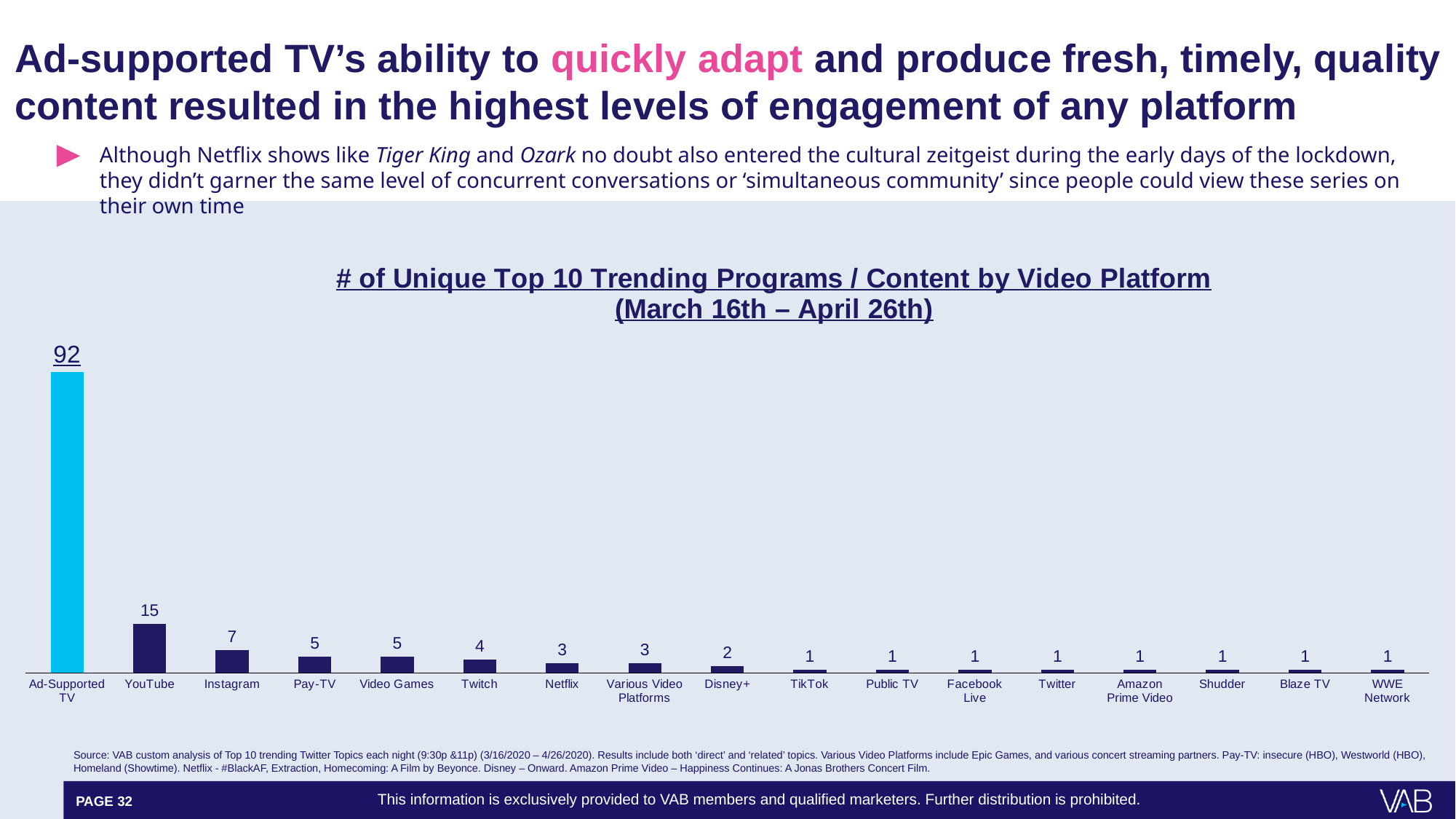
What is the value for YouTube? 15 What is the value for Ad-Supported TV? 92 How many platforms have a value of 1? 8 What is the difference between the values for Ad-Supported TV and YouTube? 77 Do the values rise or fall moving from left to right along the x axis? Fall Which platform has the highest number of unique top 10 trending programs? Ad-Supported TV How many platforms are shown on the x axis of the chart? 17 What is the value for Disney+? 2 What is the difference between the values for YouTube and Instagram? 8 What is the value for Netflix? 3 Which is larger, the value for Twitch or the value for Netflix? Twitch What kind of chart is shown on the slide? Bar chart